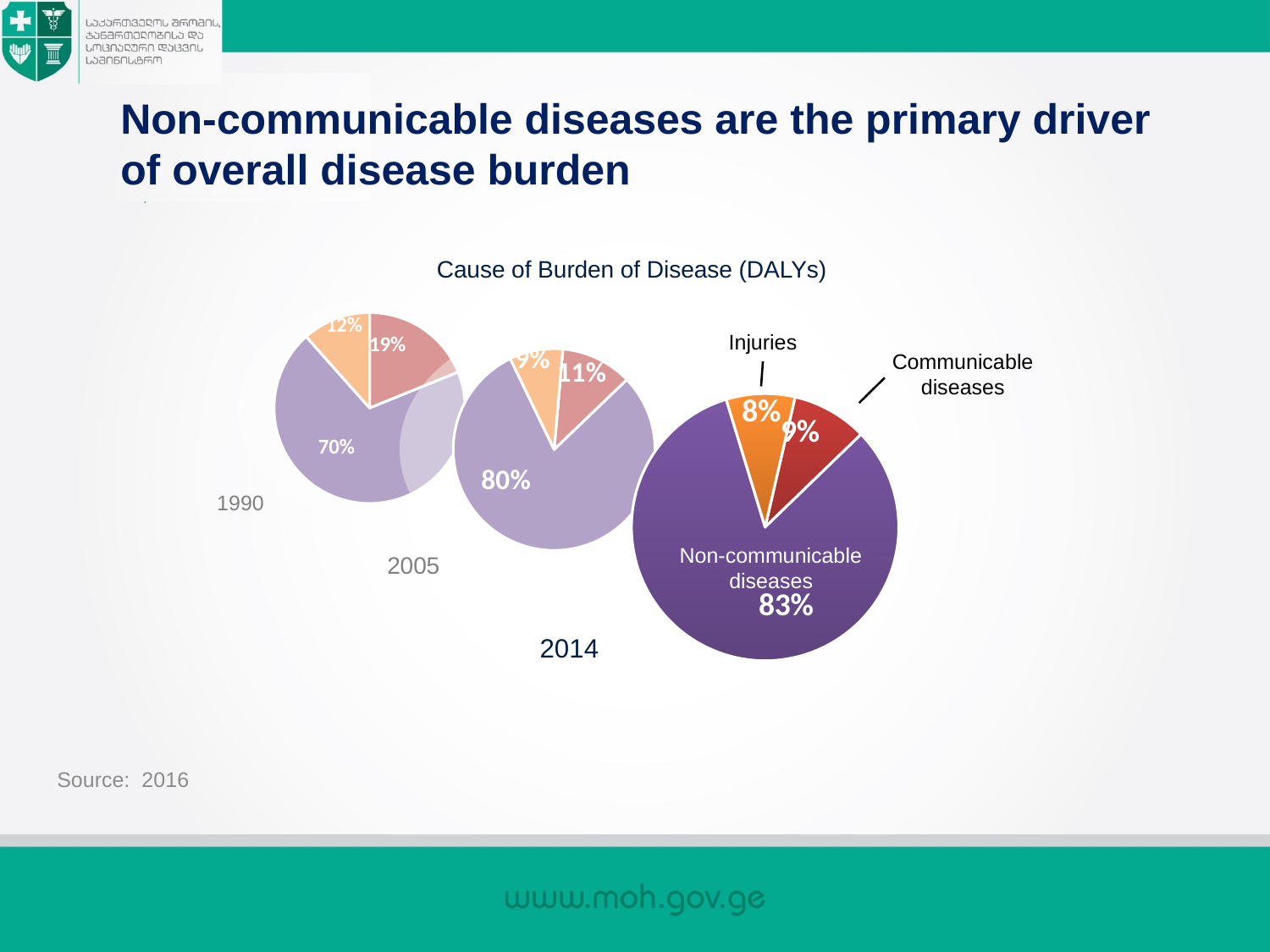
How many pie charts are shown on the slide? 3 In the 2005 pie chart, what is the value of the largest slice? 80% In the 2014 pie chart, what share is attributed to communicable diseases? 9% In the 2014 pie chart, which category has the smallest share? Injuries In the 2014 pie chart, what share is attributed to injuries? 8% What is the title shown above the pie charts? Cause of Burden of Disease (DALYs) By how many percentage points did the largest slice grow from the 1990 pie chart to the 2014 pie chart? 13 In the 2014 pie chart, what share of the burden of disease is attributed to non-communicable diseases? 83% Does the largest slice rise or fall across the 1990, 2005 and 2014 pie charts? Rise In the 1990 pie chart, what is the value of the largest slice? 70% In the 2014 pie chart, which is larger: the share for communicable diseases or the share for injuries? Communicable diseases What type of chart is used to show the cause of burden of disease? Pie chart